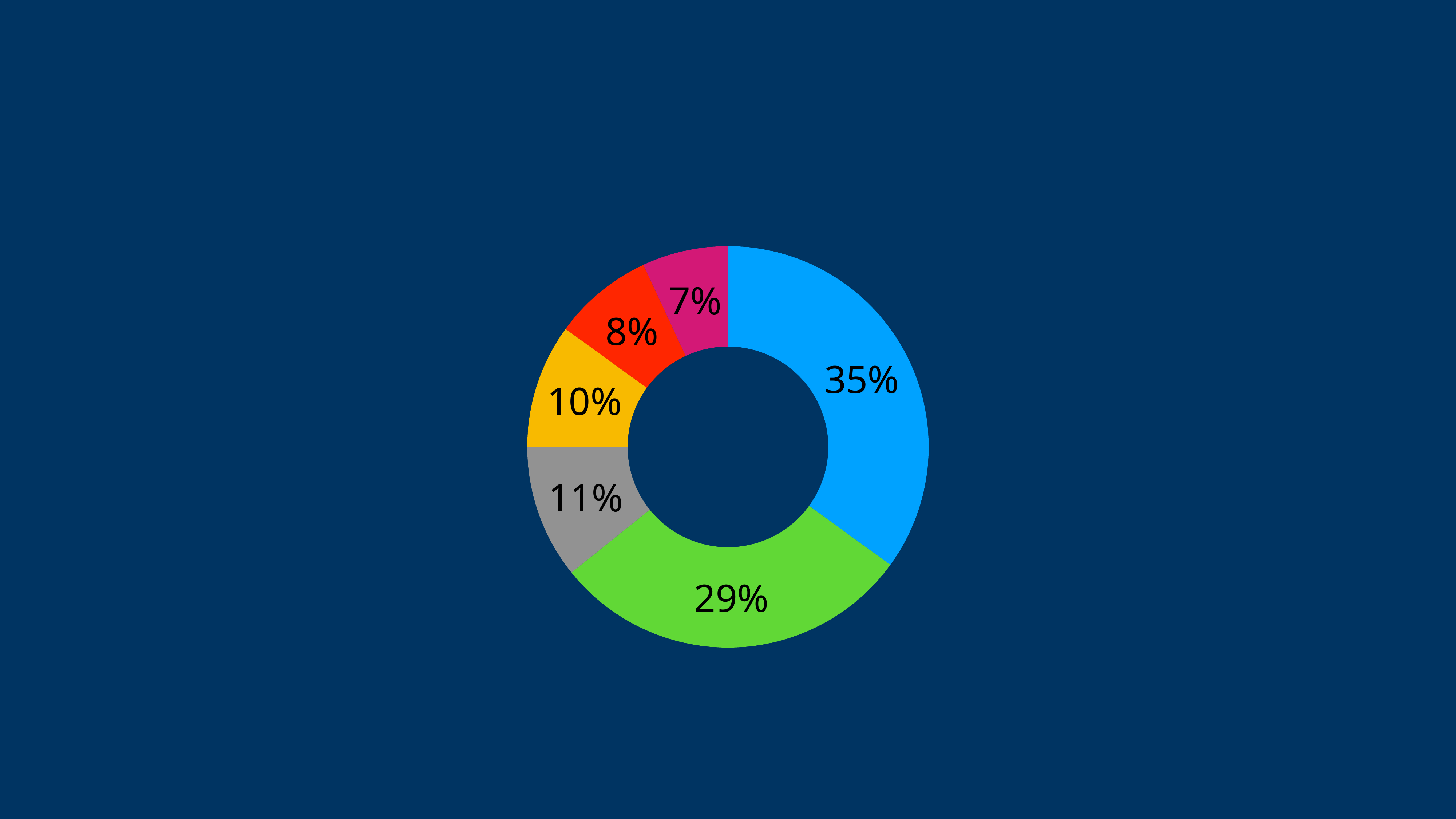
What percentage is shown on the yellow slice? 10% What percentage is shown on the blue slice? 35% What percentage is shown on the grey slice? 11% Which is larger, the grey slice or the yellow slice? The grey slice How many slices does the doughnut chart have? 6 What percentage is shown on the green slice? 29% Which slice has the smallest share? The magenta slice (7%) What is the difference between the blue slice and the green slice? 6% Which slice has the largest share? The blue slice (35%) What kind of chart is shown on the slide? Doughnut chart What percentage is shown on the red slice? 8% What percentage is shown on the magenta slice? 7%